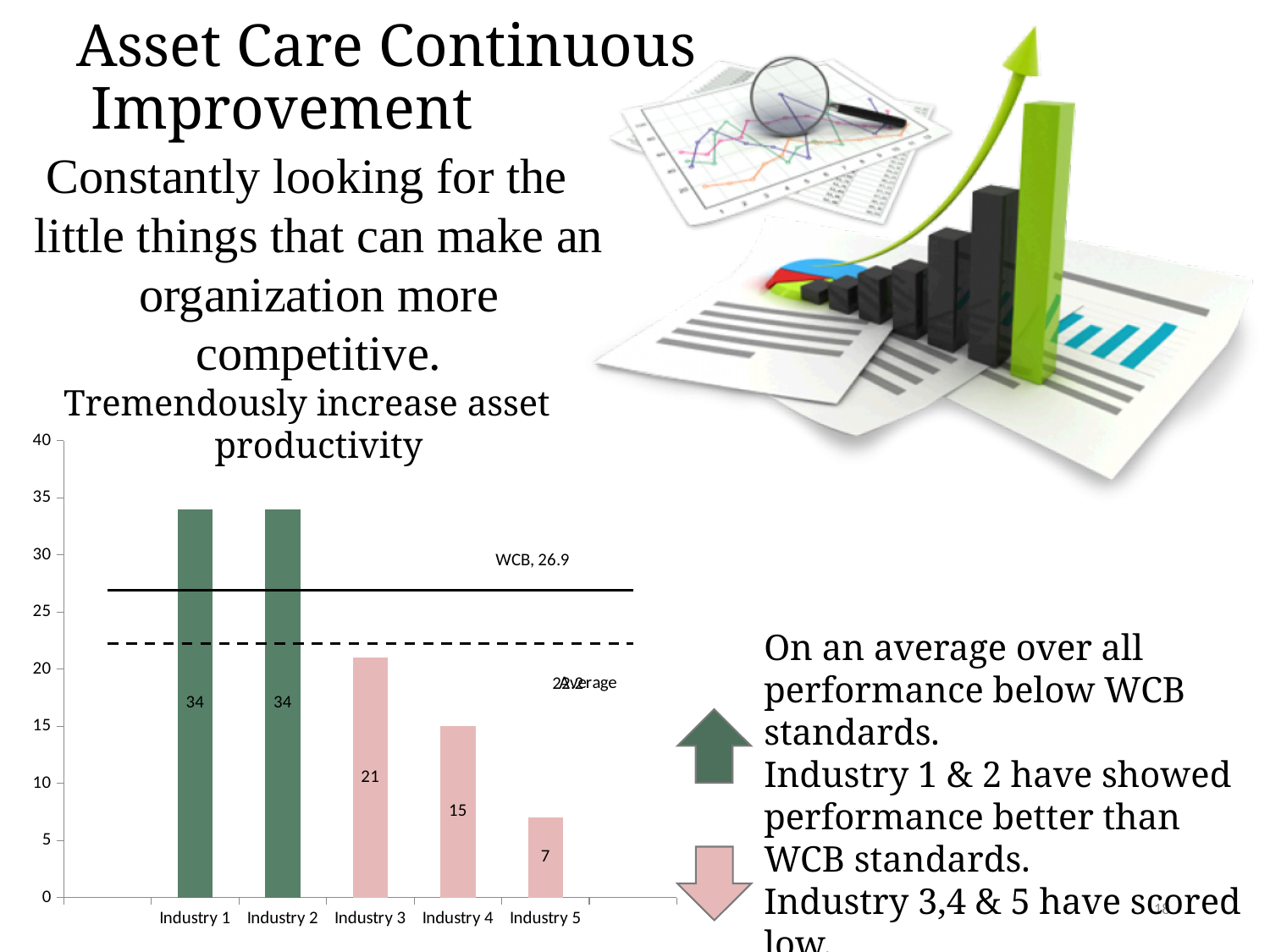
What is the value for Industry 3? 21 Which is larger, the value for Industry 3 or Industry 4? Industry 3 What is the value for Industry 4? 15 Which industry has the lowest value? Industry 5 What value is shown for the WCB line? 26.9 What is the difference between the values for Industry 3 and Industry 4? 6 How many industries are shown on the x axis? 5 What kind of chart is shown on the slide? bar chart Do the bar values rise or fall from Industry 2 to Industry 5? fall What is the difference between the values for Industry 1 and Industry 5? 27 Is the value for Industry 4 greater or less than 20? less What is the value for Industry 5? 7